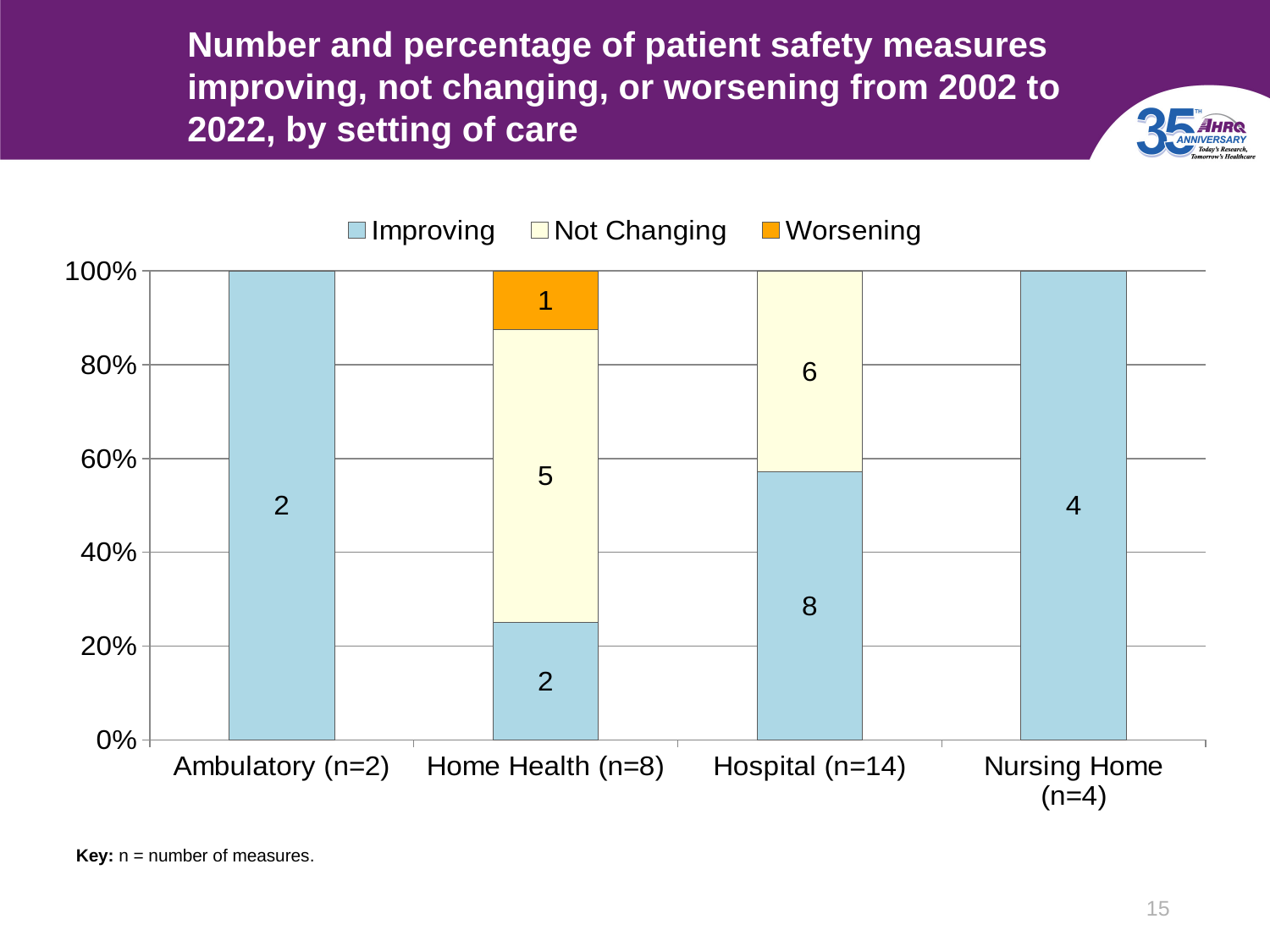
Which has more Improving measures, Hospital (n=14) or Nursing Home (n=4)? Hospital (n=14) Which setting of care has the most Improving measures? Hospital (n=14) What is the difference between the number of Not Changing measures for Hospital (n=14) and Home Health (n=8)? 1 What kind of chart is shown on the slide? Stacked bar chart Is the Improving share of the Hospital (n=14) bar greater or less than 40%? greater How many Improving measures are shown for Hospital (n=14)? 8 How many Improving measures are shown for Nursing Home (n=4)? 4 How many settings of care are shown on the x axis? 4 How many series does the legend list? 3 Which setting of care is the only one with a Worsening segment? Home Health (n=8) How many Worsening measures are shown for Home Health (n=8)? 1 How many Not Changing measures are shown for Home Health (n=8)? 5